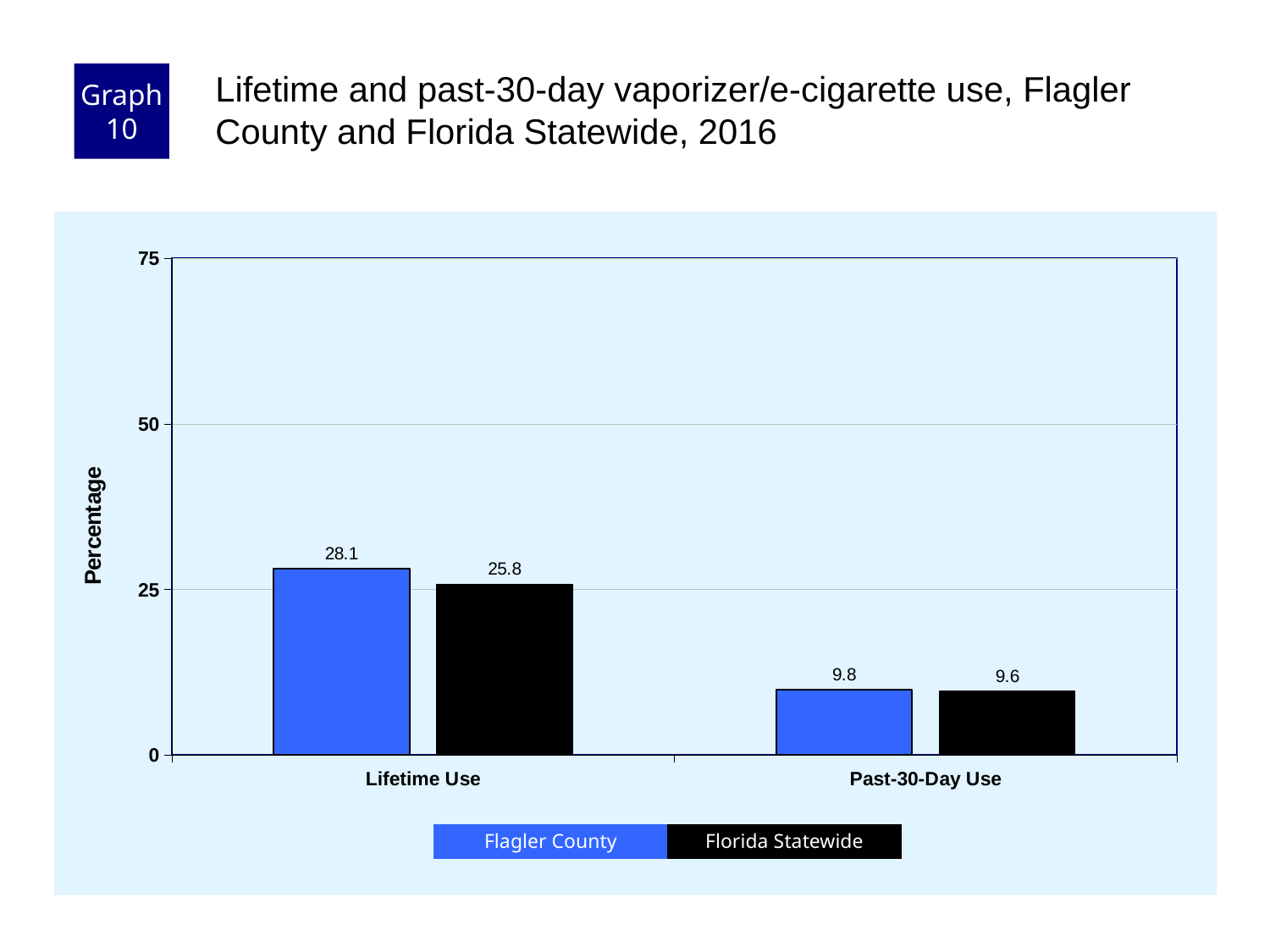
What kind of chart is shown on the slide? bar chart How many categories are shown on the x axis? 2 What is the Florida Statewide value for Lifetime Use? 25.8 Which category has the highest Flagler County value? Lifetime Use What is the difference between the Flagler County and Florida Statewide values for Lifetime Use? 2.3 Which category has the lowest Florida Statewide value? Past-30-Day Use What is the Florida Statewide value for Past-30-Day Use? 9.6 What is the Flagler County value for Lifetime Use? 28.1 What is the label of the y axis? Percentage Is the Flagler County value for Lifetime Use greater or less than 25? greater How many series does the legend list? 2 Which is larger for Past-30-Day Use, Flagler County or Florida Statewide? Flagler County